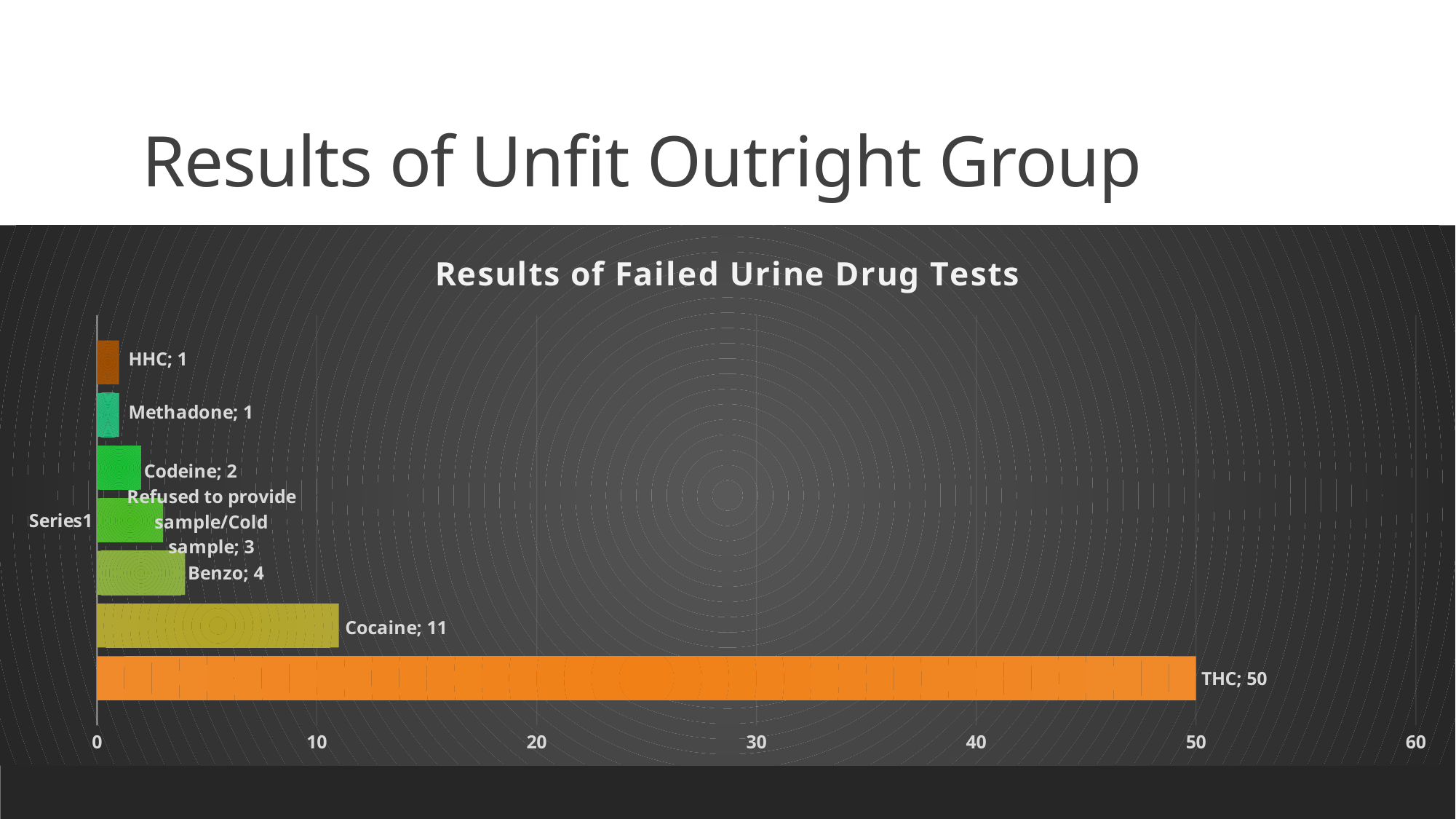
What is the difference between the values for THC and Cocaine? 39 Which category has the highest value? THC What kind of chart is shown on the slide? bar chart What is the title of the chart? Results of Failed Urine Drug Tests What is the value for Refused to provide sample/Cold sample? 3 What is the value for Benzo? 4 Which is larger, the value for Benzo or the value for Codeine? Benzo What is the difference between the values for Cocaine and Benzo? 7 How many categories are shown in the chart? 7 Is the value for THC greater or less than 40? greater What is the value for Cocaine? 11 What is the value for THC? 50